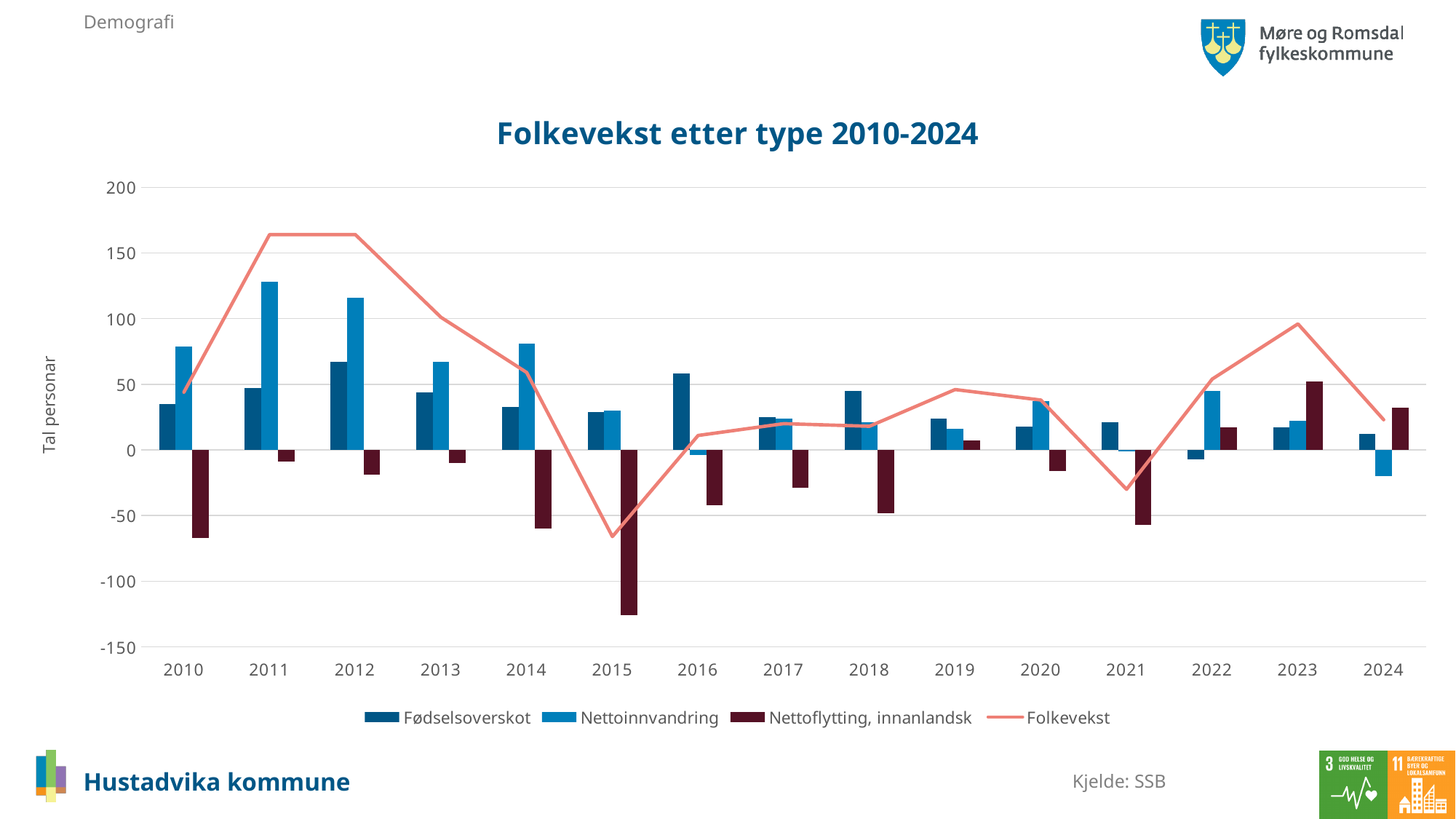
In which year is Nettoflytting, innanlandsk lowest? 2015 How many years are shown on the x axis? 15 In which year is Fødselsoverskot highest? 2012 In 2012, which is larger: Fødselsoverskot or Nettoinnvandring? Nettoinnvandring Does the Folkevekst line rise or fall from 2012 to 2015? fall What kind of chart is shown on the slide? bar chart with a line In which year is the Folkevekst line at its lowest? 2015 What is the label on the y axis? Tal personar Is the value for Nettoflytting, innanlandsk in 2015 greater or less than -100? less Is the value for Nettoinnvandring in 2011 greater or less than 100? greater In which year is Nettoinnvandring highest? 2011 How many series does the legend list? 4